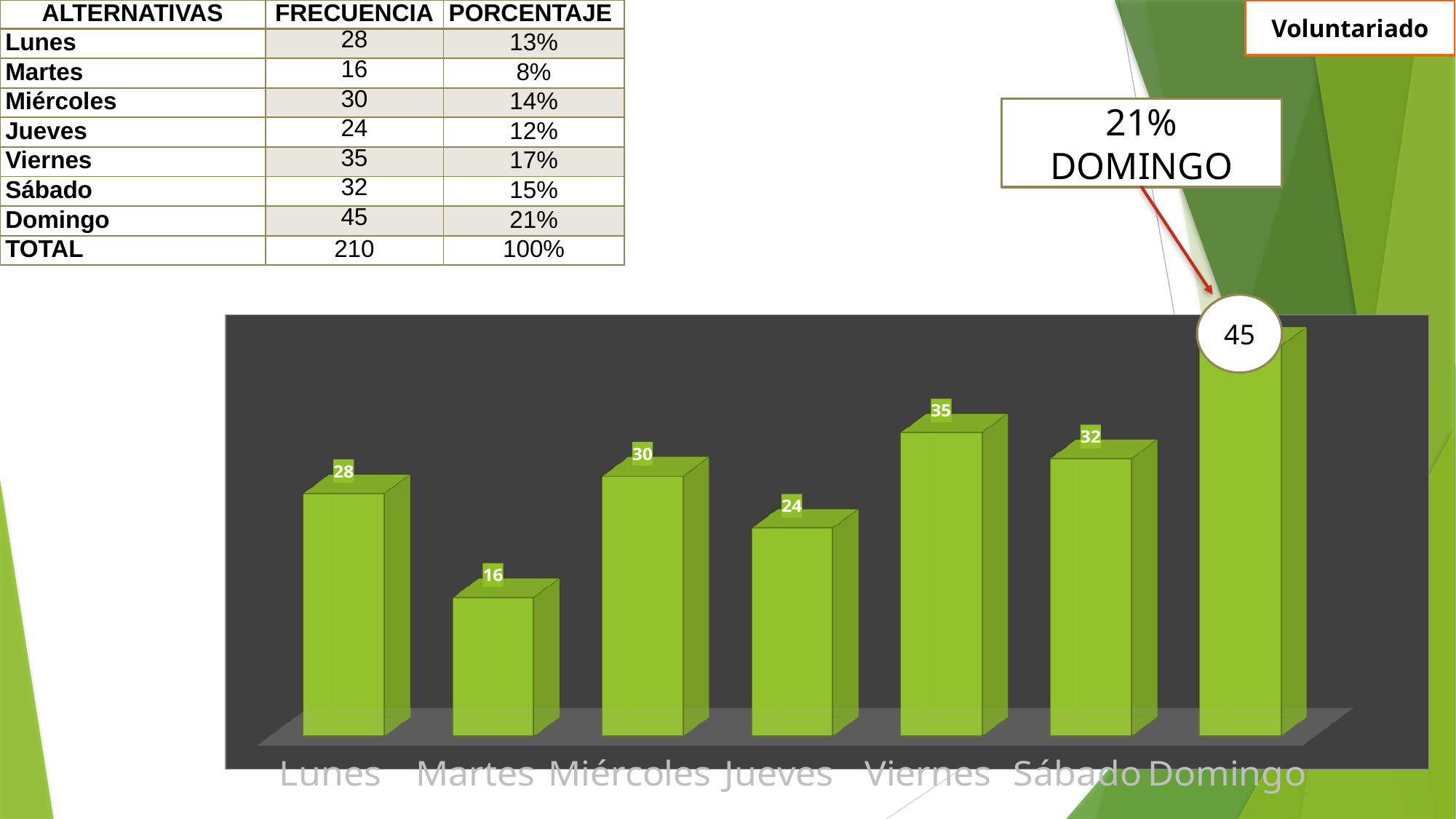
What percentage is shown in the callout box pointing to the Domingo bar? 21% How many days (categories) are shown on the x axis of the chart? 7 Which is larger, the value for Miércoles or the value for Jueves? Miércoles Which day has the highest bar? Domingo What is the difference between the values for Domingo and Lunes? 17 Which day has the lowest bar? Martes What is the value of the bar for Jueves? 24 What is the difference between the values for Sábado and Martes? 16 What is the value of the bar for Martes? 16 What is the value of the bar for Viernes? 35 Which is larger, the value for Viernes or the value for Sábado? Viernes What kind of chart is shown on the slide? Bar chart